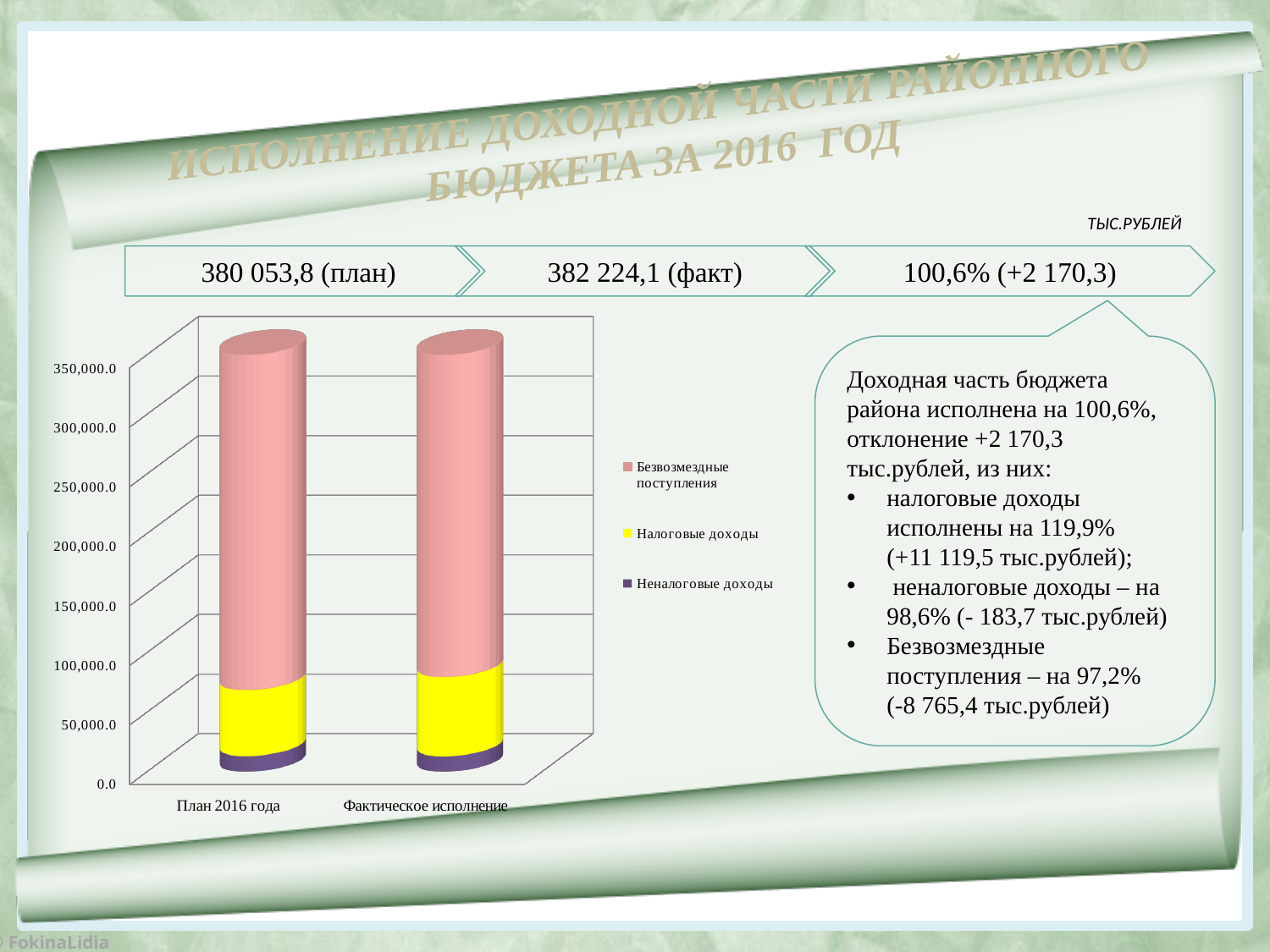
Which series is shown in pink at the top of each stacked bar? Безвозмездные поступления Is the total height of the 'План 2016 года' bar greater or less than 350,000.0? greater Is the 'Безвозмездные поступления' segment of the 'Фактическое исполнение' bar greater or less than 250,000.0? greater What kind of chart is shown on the slide? Bar chart (stacked) How many series does the chart legend list? 3 Which bar has the larger 'Налоговые доходы' segment, 'План 2016 года' or 'Фактическое исполнение'? Фактическое исполнение How many categories are shown on the x axis of the chart? 2 What is the label of the first category on the x axis of the chart? План 2016 года Which series forms the smallest segment in both stacked bars? Неналоговые доходы Which series is shown in yellow in the chart? Налоговые доходы Is the 'Неналоговые доходы' segment of the 'План 2016 года' bar greater or less than 50,000.0? less